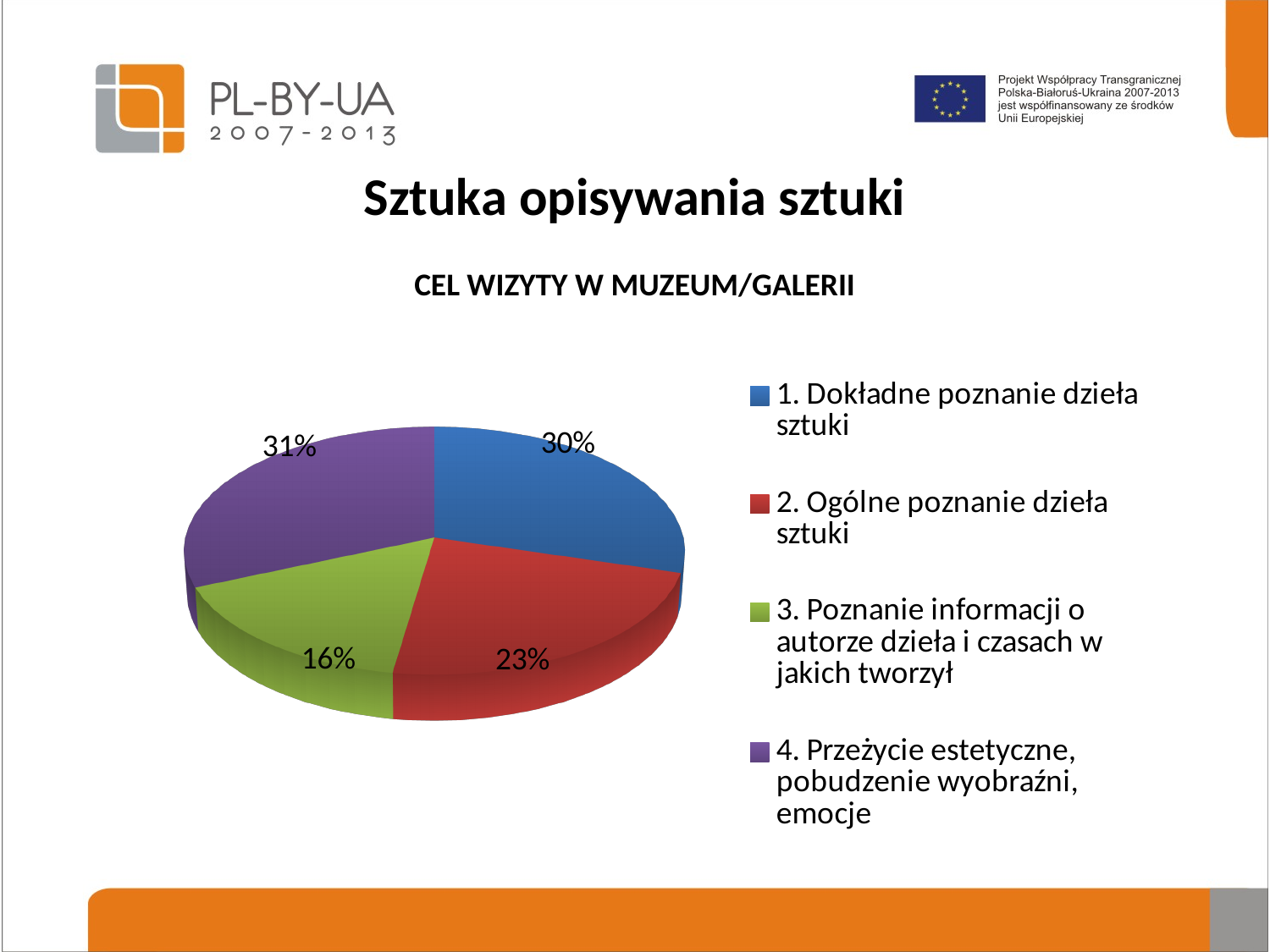
What type of chart is shown on the slide? pie chart What colour is the slice for '3. Poznanie informacji o autorze dzieła i czasach w jakich tworzył'? green Which is larger: the slice for '1. Dokładne poznanie dzieła sztuki' or the slice for '2. Ogólne poznanie dzieła sztuki'? 1. Dokładne poznanie dzieła sztuki Which category has the smallest slice of the pie? 3. Poznanie informacji o autorze dzieła i czasach w jakich tworzył What is the difference in percentage points between '2. Ogólne poznanie dzieła sztuki' and '3. Poznanie informacji o autorze dzieła i czasach w jakich tworzył'? 7 percentage points What share of the pie is labelled for '1. Dokładne poznanie dzieła sztuki'? 30% How many categories does the legend list? 4 What share of the pie is labelled for '4. Przeżycie estetyczne, pobudzenie wyobraźni, emocje'? 31% Which category has the largest slice of the pie? 4. Przeżycie estetyczne, pobudzenie wyobraźni, emocje What share of the pie is labelled for '2. Ogólne poznanie dzieła sztuki'? 23% What share of the pie is labelled for '3. Poznanie informacji o autorze dzieła i czasach w jakich tworzył'? 16% What is the title of the chart? CEL WIZYTY W MUZEUM/GALERII